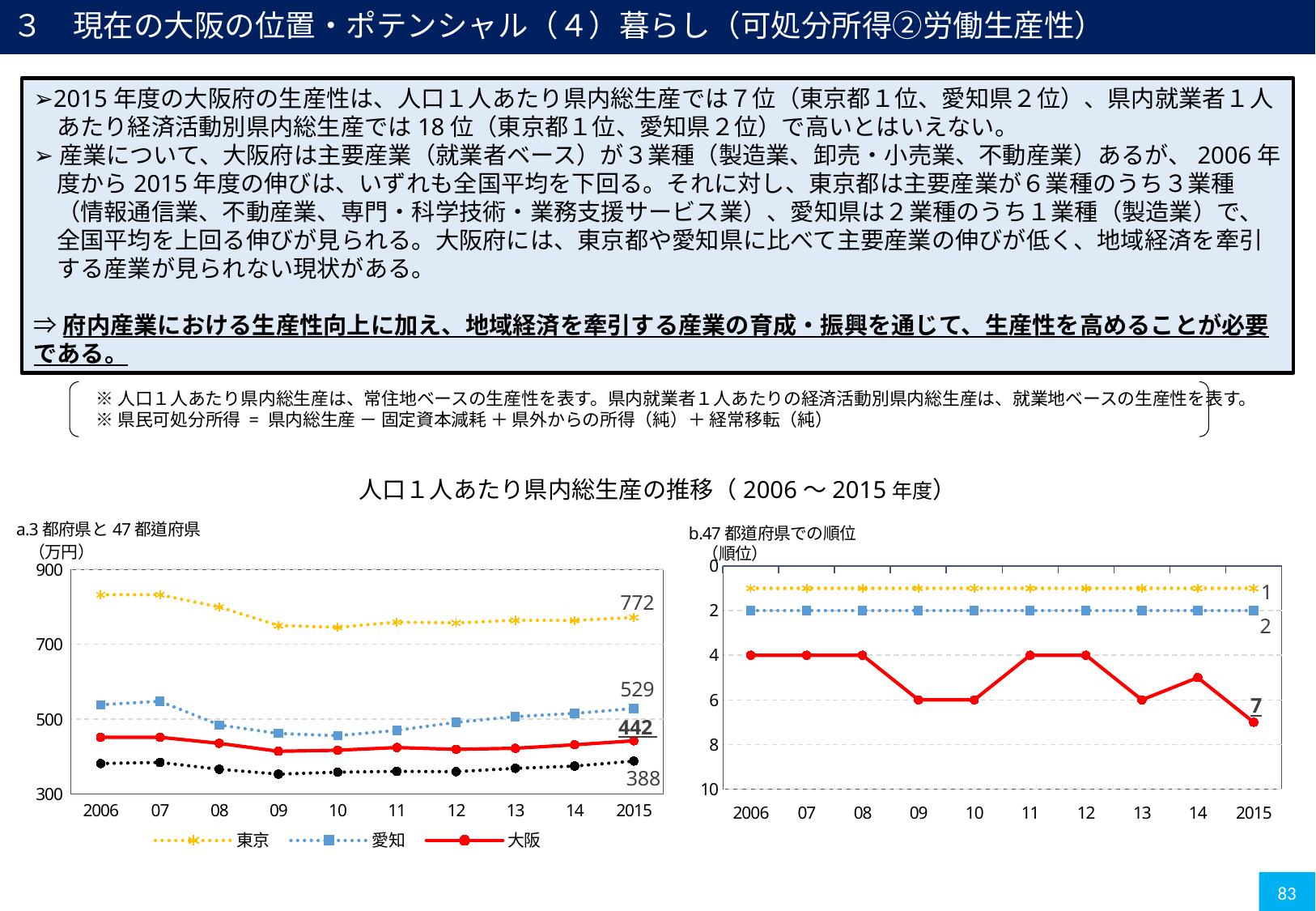
In the left chart (a.3都府県と47都道府県), what is the value for 東京 in 2015? 772 In the left chart (a.3都府県と47都道府県), what is the value for 愛知 in 2015? 529 What kind of chart is the left chart (a.3都府県と47都道府県)? line chart In the left chart (a.3都府県と47都道府県), is the value for 大阪 in 2006 greater or less than 500? less In the left chart (a.3都府県と47都道府県), what is the value for 大阪 in 2015? 442 In the left chart (a.3都府県と47都道府県), which is larger in 2015, 愛知 or 大阪? 愛知 In the right chart (b.47都道府県での順位), what is the rank of 大阪 in 2015? 7 How many years are shown on the x axis of the left chart (a.3都府県と47都道府県)? 10 How many series does the legend of the left chart (a.3都府県と47都道府県) list? 3 In the right chart (b.47都道府県での順位), what is the rank of 東京 in 2015? 1 In the left chart (a.3都府県と47都道府県), what is the difference between the 2015 values for 東京 and 大阪? 330 In the left chart (a.3都府県と47都道府県), which of the legend series has the highest value in 2015? 東京